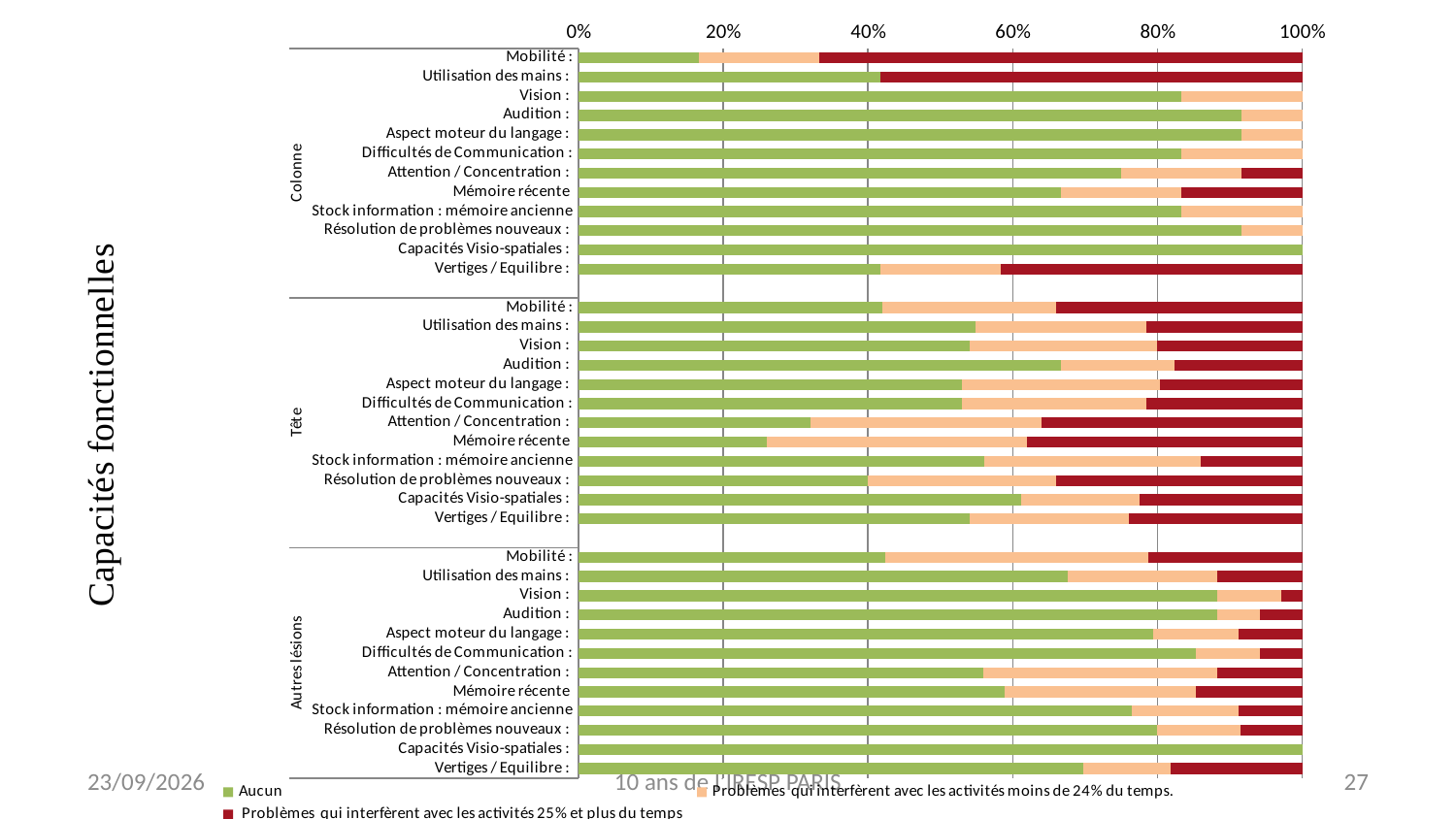
In the 'Tête' group, is the 'Aucun' share for 'Mémoire récente' greater or less than 20%? greater How many groups (Colonne, Tête, Autres lésions) are shown on the chart? 3 Which is larger: the 'Aucun' share for 'Mobilité' in the 'Colonne' group or in the 'Tête' group? Tête What colour represents the 'Aucun' series in the legend? Green How many series does the legend list? 3 How many categories are plotted within the 'Colonne' group? 12 In the 'Colonne' group, is the 'Aucun' share for 'Mobilité' greater or less than 20%? less In the 'Tête' group, is the 'Aucun' share for 'Attention / Concentration' greater or less than 40%? less What kind of chart is shown on the slide? Stacked bar chart In the 'Tête' group, which category has the smallest 'Aucun' share? Mémoire récente In the 'Colonne' group, which category has the smallest 'Aucun' share? Mobilité